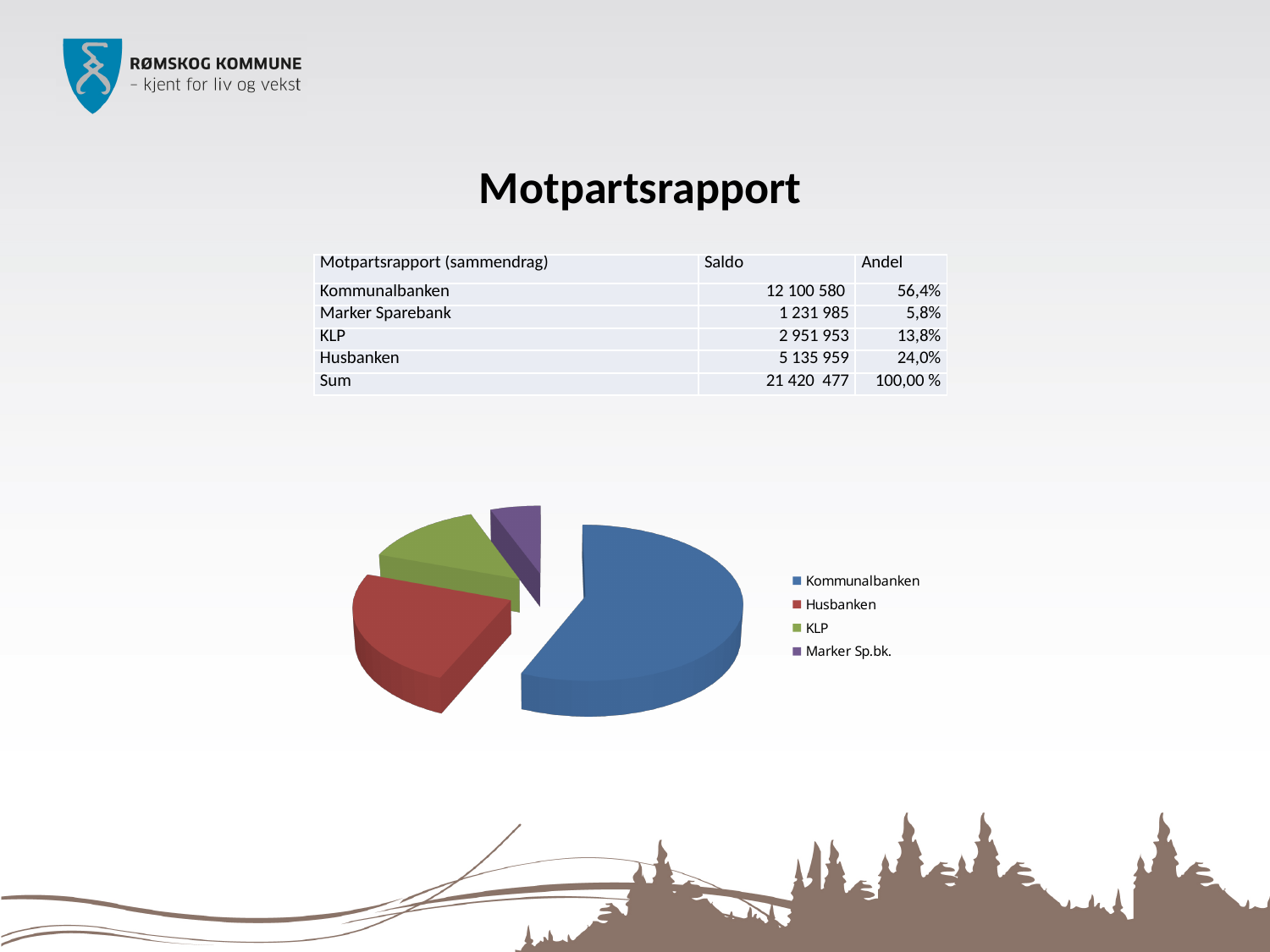
What is the difference between the Saldo for Kommunalbanken and the Saldo for Husbanken? 6 964 621 What kind of chart is shown on the slide? Pie chart What share of the pie does Husbanken represent, according to the table on the slide? 24,0% In the pie chart, which slice is larger, Husbanken or KLP? Husbanken How many slices does the pie chart have? 4 What is the Saldo value for KLP in the table on the slide? 2 951 953 What share of the pie does Kommunalbanken represent, according to the table on the slide? 56,4% How many entries does the pie chart's legend list? 4 Which category has the largest slice in the pie chart? Kommunalbanken Which category has the smallest slice in the pie chart? Marker Sp.bk. What colour is the Kommunalbanken slice in the pie chart? Blue What is the total (Sum) of the Saldo values shown in the table? 21 420 477